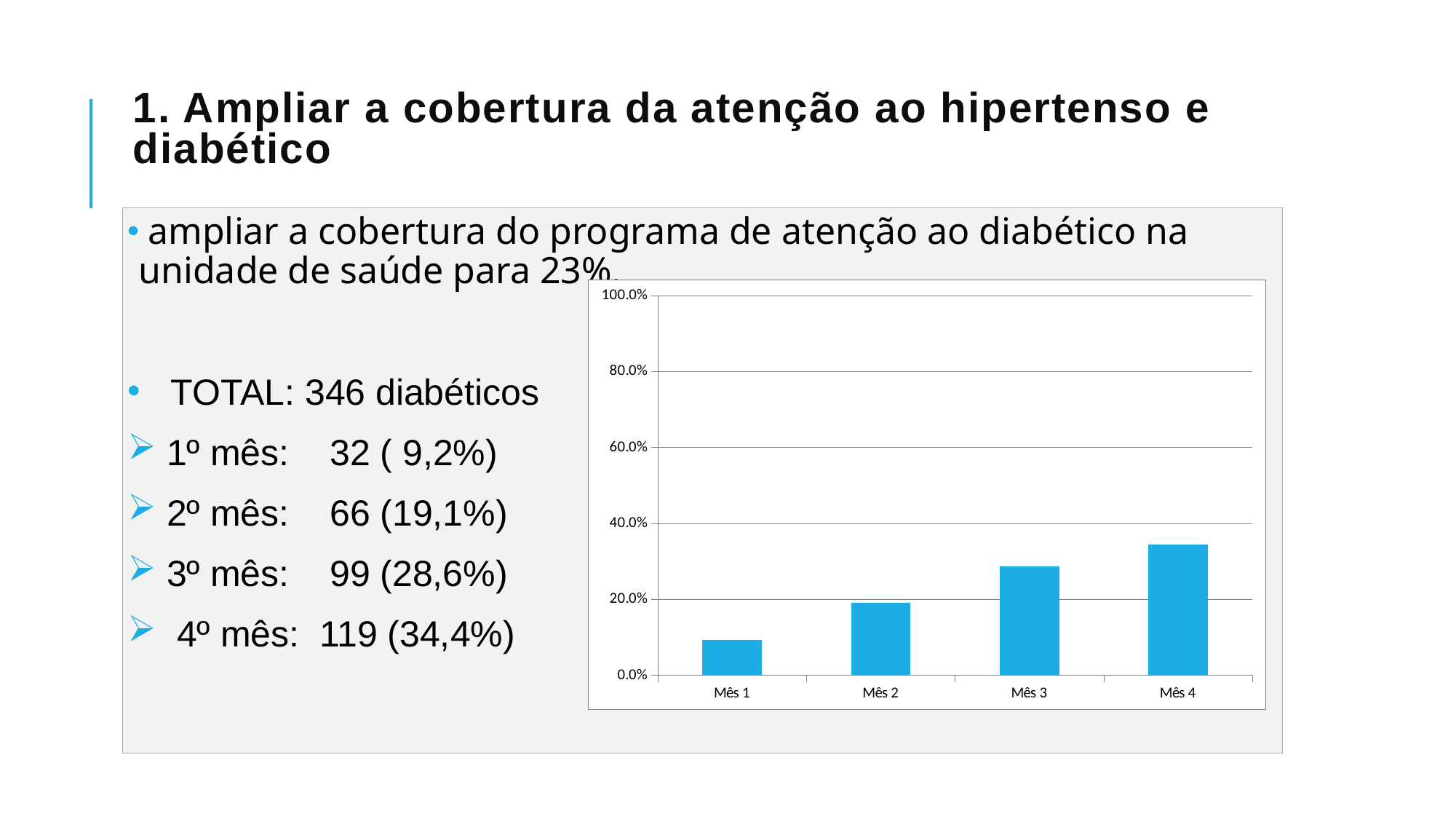
Do the values in the chart rise or fall from Mês 1 to Mês 4? rise Which month has the lowest bar in the chart? Mês 1 Which month has the highest bar in the chart? Mês 4 Is the value for Mês 4 greater or less than 20.0%? greater Is the value for Mês 4 greater or less than 40.0%? less What kind of chart is shown on the slide? bar chart Is the value for Mês 1 greater or less than 20.0%? less How many months (categories) are plotted on the x axis of the chart? 4 What is the maximum value shown on the chart's y axis? 100.0% Which is larger in the chart, the value for Mês 2 or the value for Mês 3? Mês 3